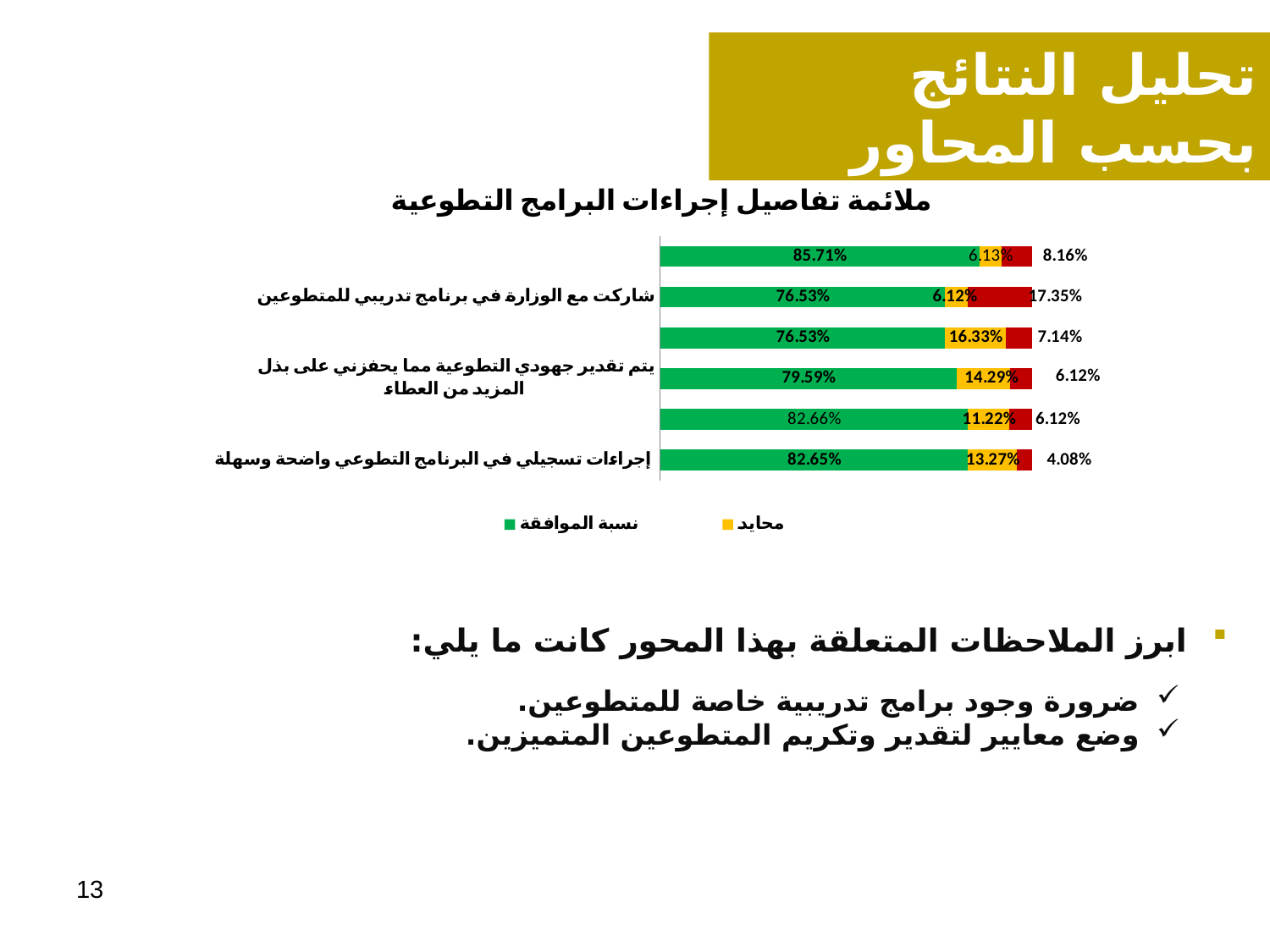
Which is larger: the agreement percentage for 'إجراءات تسجيلي في البرنامج التطوعي واضحة وسهلة' or for 'شاركت مع الوزارة في برنامج تدريبي للمتطوعين'? إجراءات تسجيلي في البرنامج التطوعي واضحة وسهلة What is the agreement percentage (نسبة الموافقة) for 'شاركت مع الوزارة في برنامج تدريبي للمتطوعين'? 76.53% What is the highest agreement percentage (نسبة الموافقة) shown in the chart? 85.71% How many entries does the chart legend list? 2 What is the title of the chart? ملائمة تفاصيل إجراءات البرامج التطوعية How many bars are plotted in the chart? 6 What is the agreement percentage (نسبة الموافقة) for 'إجراءات تسجيلي في البرنامج التطوعي واضحة وسهلة'? 82.65% What is the neutral (محايد) percentage for 'يتم تقدير جهودي التطوعية مما يحفزني على بذل المزيد من العطاء'? 14.29% What is the smallest red segment value shown in the chart? 4.08% What is the red segment value for 'شاركت مع الوزارة في برنامج تدريبي للمتطوعين'? 17.35% What is the difference between the agreement percentages for 'إجراءات تسجيلي في البرنامج التطوعي واضحة وسهلة' and 'شاركت مع الوزارة في برنامج تدريبي للمتطوعين'? 6.12% What type of chart is shown on the slide? Stacked bar chart